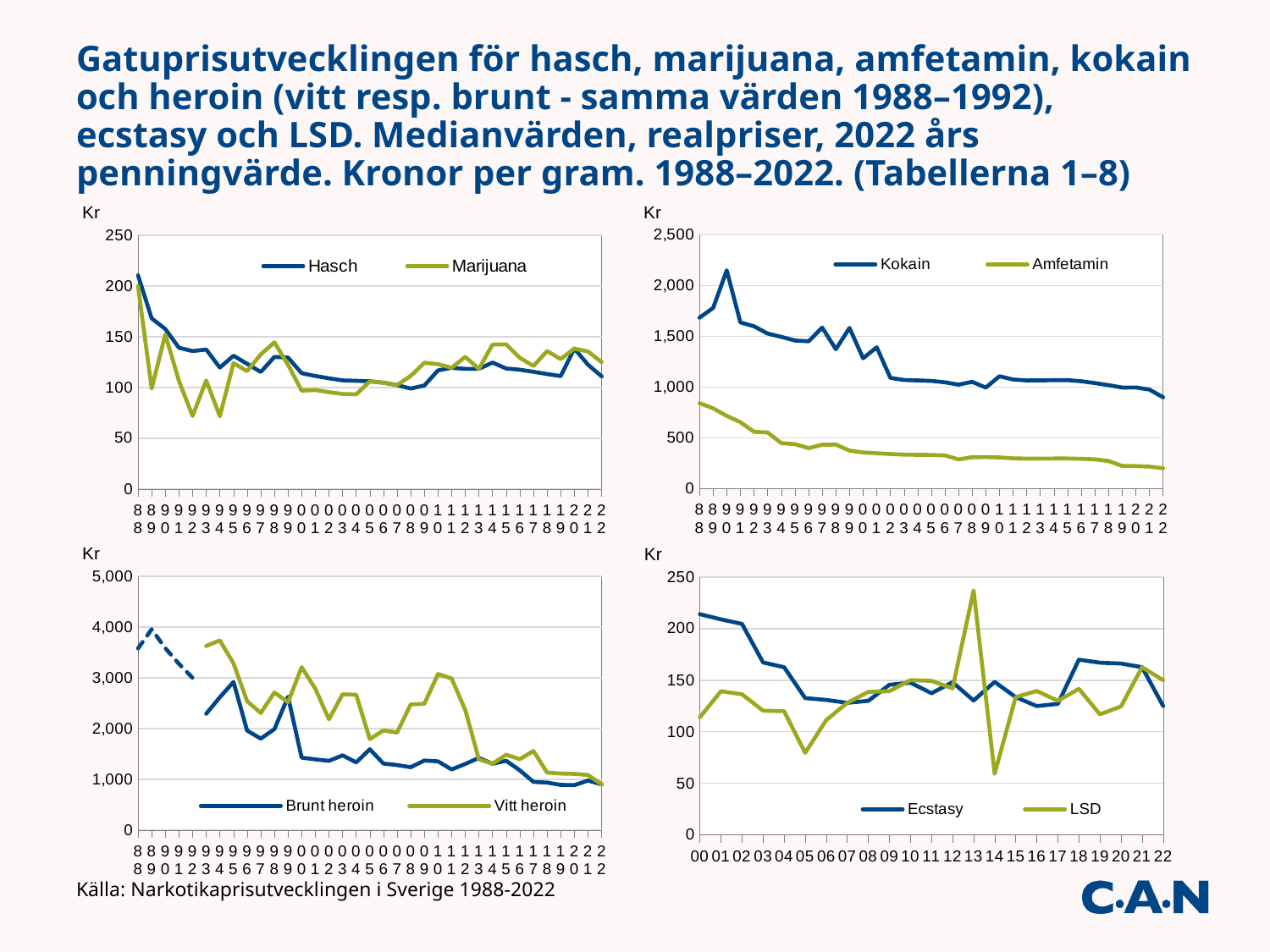
In the bottom-left chart, do the values for Vitt heroin generally rise or fall from 1993 to 2022? fall In the top-right chart, is the value for Kokain in 1989 greater or less than 2,000? less In the top-right chart, which series has higher values throughout the period, Kokain or Amfetamin? Kokain What kind of chart is the top-left chart showing Hasch and Marijuana? Line chart In the top-left chart, is the value for Hasch in 1988 greater or less than 200? greater In the bottom-right chart, which series has the higher value in 2014, Ecstasy or LSD? Ecstasy In the top-right chart, do the values for Kokain generally rise or fall from 1988 to 2022? fall How many series does the legend of the top-right chart (Kokain and Amfetamin) list? 2 In the bottom-left chart, is the value for Brunt heroin in 1989 greater or less than 3,000? greater How many charts are shown on the slide? 4